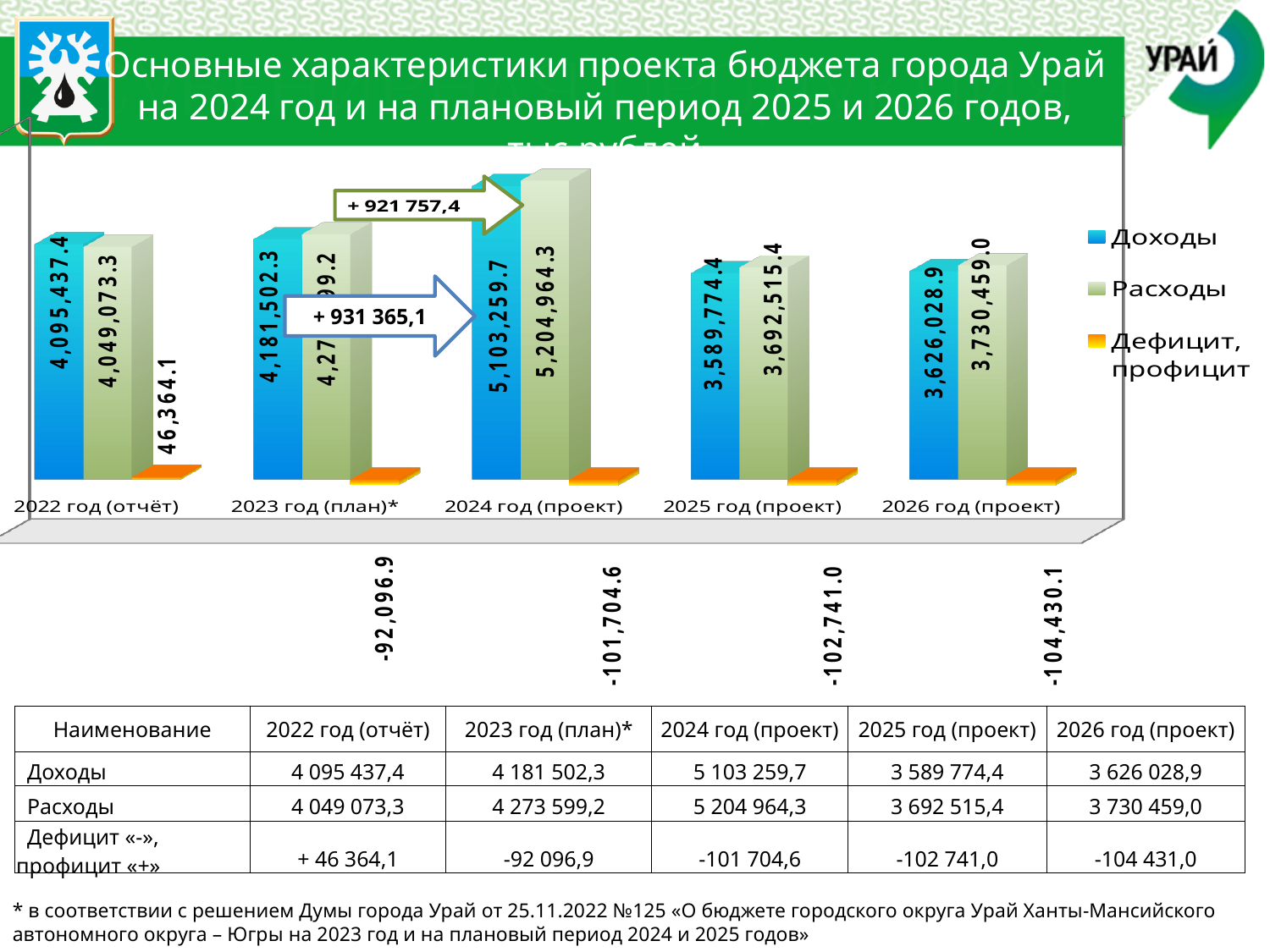
What is the difference between Расходы and Доходы for 2024 год (проект)? 101,704.6 How many year categories are shown on the x axis of the chart? 5 What is the Дефицит, профицит value shown for 2023 год (план)*? -92,096.9 Which year has the highest Доходы value in the chart? 2024 год (проект) Which series is shown in orange in the chart legend? Дефицит, профицит What is the value of Расходы for 2022 год (отчёт) in the chart? 4,049,073.3 How many series does the chart legend list? 3 What type of chart is shown on the slide? bar chart Which year has the lowest Расходы value in the chart? 2025 год (проект) Which is larger for 2025 год (проект): Доходы or Расходы? Расходы What is the value of Доходы for 2024 год (проект) in the chart? 5,103,259.7 What is the value of Доходы for 2026 год (проект) in the chart? 3,626,028.9